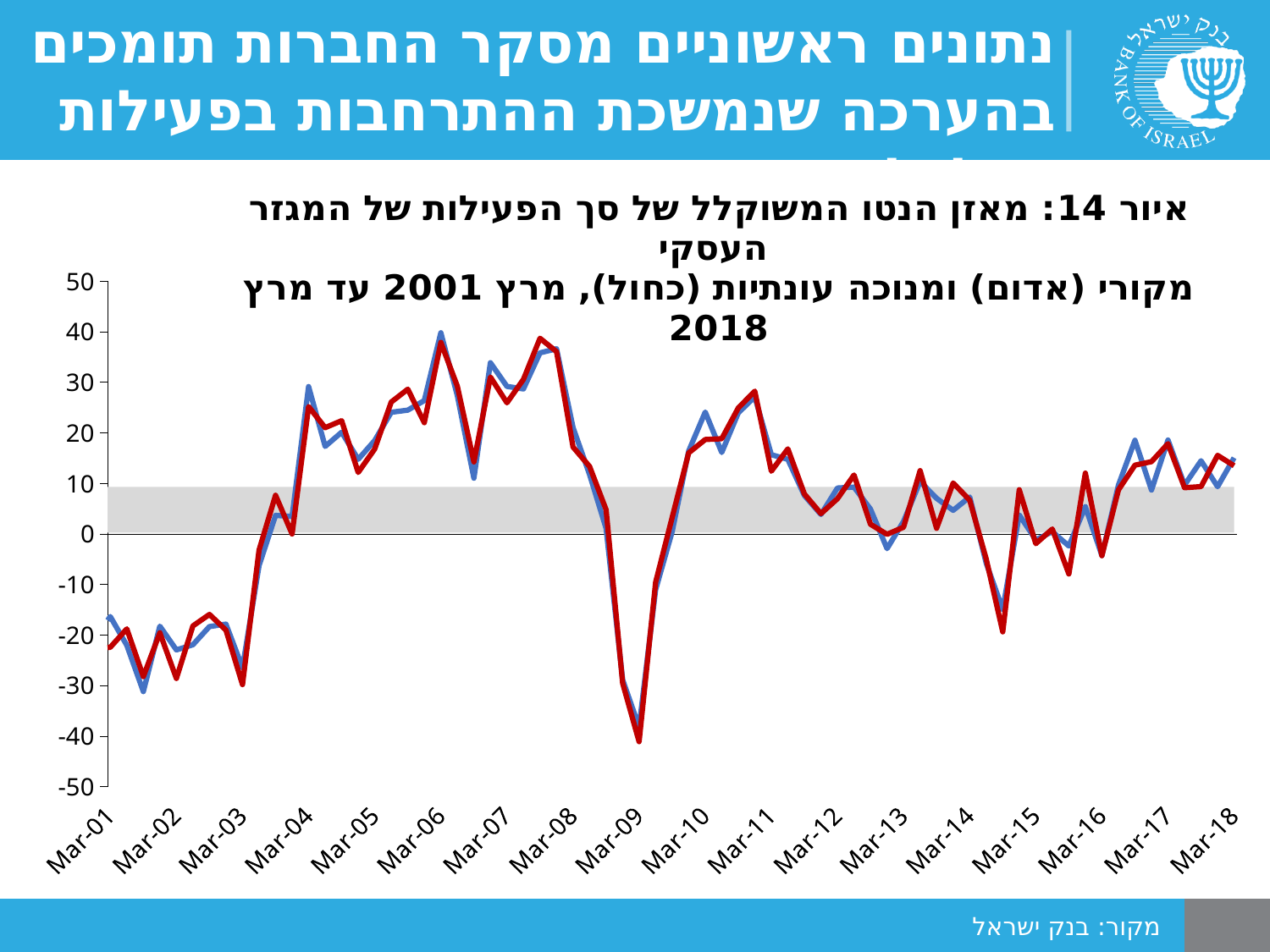
Near which x-axis label does the red line reach its lowest value? Mar-09 Do the values rise or fall between Mar-01 and Mar-04? rise What is the highest value shown on the y axis? 50 Is the lowest point of the red line greater or less than -30? less Is the value of the red line at Mar-01 greater or less than -10? less What kind of chart is shown on the slide? line chart How many lines (series) are plotted on the chart? 2 Do the values rise or fall between Mar-08 and Mar-09? fall Is the highest point of the red line greater or less than 30? greater How many date labels are shown on the x axis? 18 According to the chart title, which colour represents the original (unadjusted) series? red